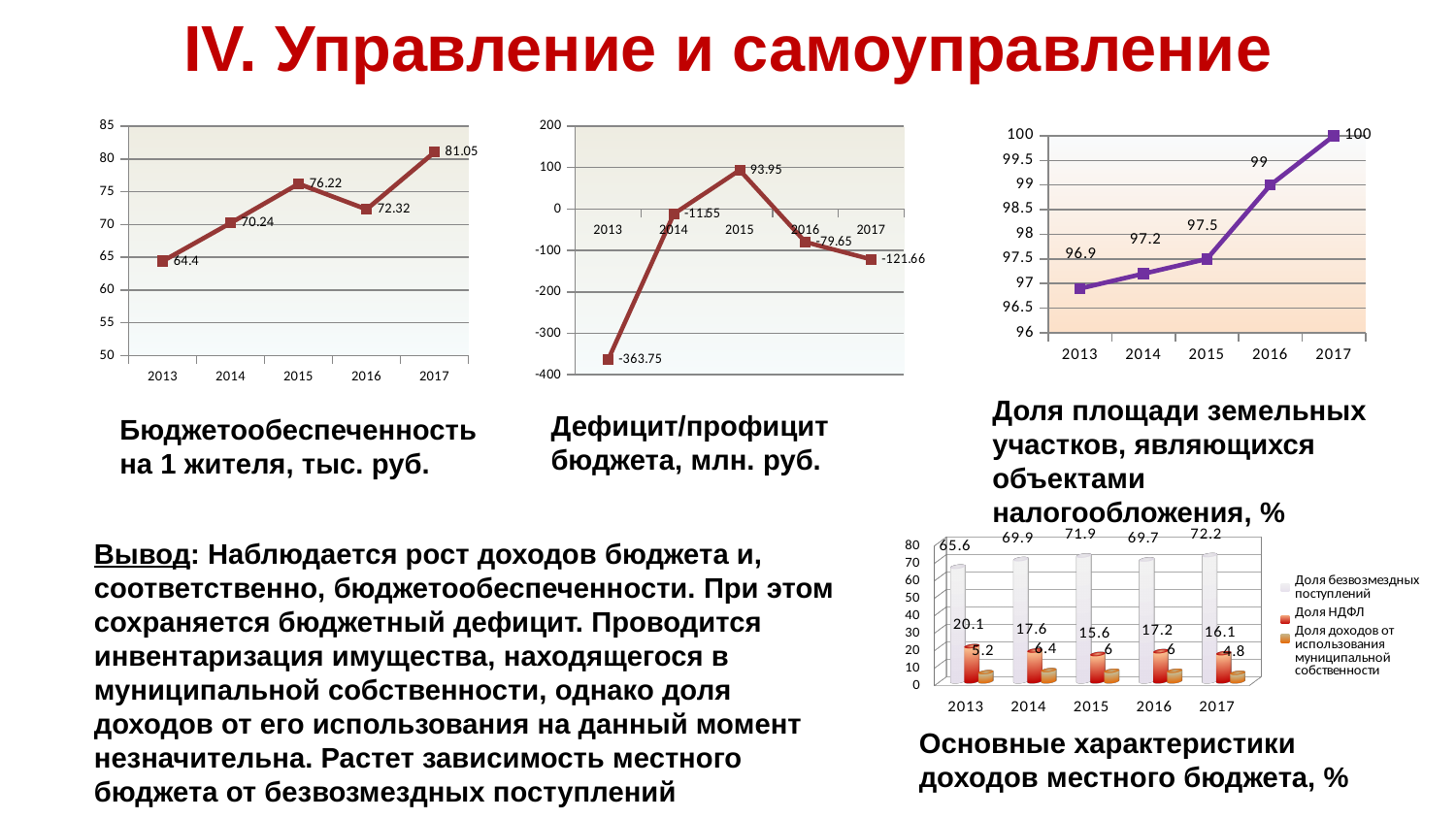
On the chart 'Дефицит/профицит бюджета, млн. руб.', what is the value for 2013? -363.75 On the chart 'Дефицит/профицит бюджета, млн. руб.', which year has the highest value? 2015 On the chart 'Основные характеристики доходов местного бюджета, %', how many series does the legend list? 3 On the chart 'Доля площади земельных участков, являющихся объектами налогообложения, %', do the values rise or fall from 2013 to 2017? rise On the chart 'Основные характеристики доходов местного бюджета, %', which is larger: 'Доля безвозмездных поступлений' in 2013 or in 2017? 2017 On the chart 'Бюджетообеспеченность на 1 жителя, тыс. руб.', what is the value for 2017? 81.05 On the chart 'Доля площади земельных участков, являющихся объектами налогообложения, %', what is the value for 2014? 97.2 On the chart 'Основные характеристики доходов местного бюджета, %', what is the value of 'Доля НДФЛ' for 2015? 15.6 On the chart 'Бюджетообеспеченность на 1 жителя, тыс. руб.', which year has the lowest value? 2013 On the chart 'Дефицит/профицит бюджета, млн. руб.', how many data points are plotted? 5 On the chart 'Бюджетообеспеченность на 1 жителя, тыс. руб.', what is the difference between the values for 2015 and 2016? 3.90 What kind of chart is 'Основные характеристики доходов местного бюджета, %'? bar chart